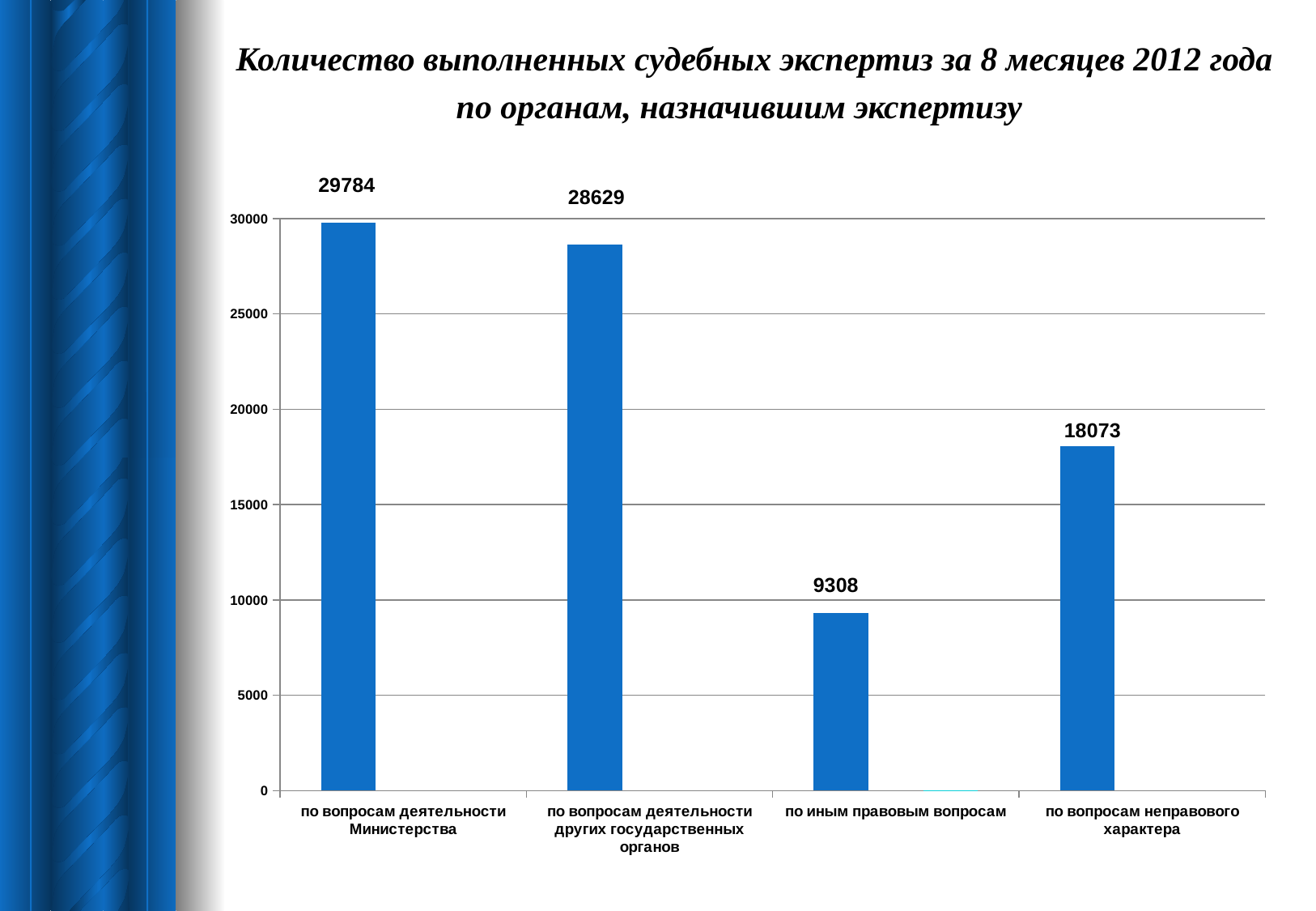
What is the difference between the values for "по вопросам деятельности Министерства" and "по вопросам деятельности других государственных органов"? 1155 Which category has the lowest value? по иным правовым вопросам Which is larger: the value for "по вопросам неправового характера" or the value for "по иным правовым вопросам"? по вопросам неправового характера What is the difference between the values for "по вопросам неправового характера" and "по иным правовым вопросам"? 8765 Is the value for "по вопросам неправового характера" greater or less than 20000? less What is the value for "по иным правовым вопросам"? 9308 How many categories are shown in the chart? 4 What is the value for "по вопросам неправового характера"? 18073 What is the value for "по вопросам деятельности Министерства"? 29784 What kind of chart is shown on the slide? bar chart What is the value for "по вопросам деятельности других государственных органов"? 28629 Which category has the highest value? по вопросам деятельности Министерства